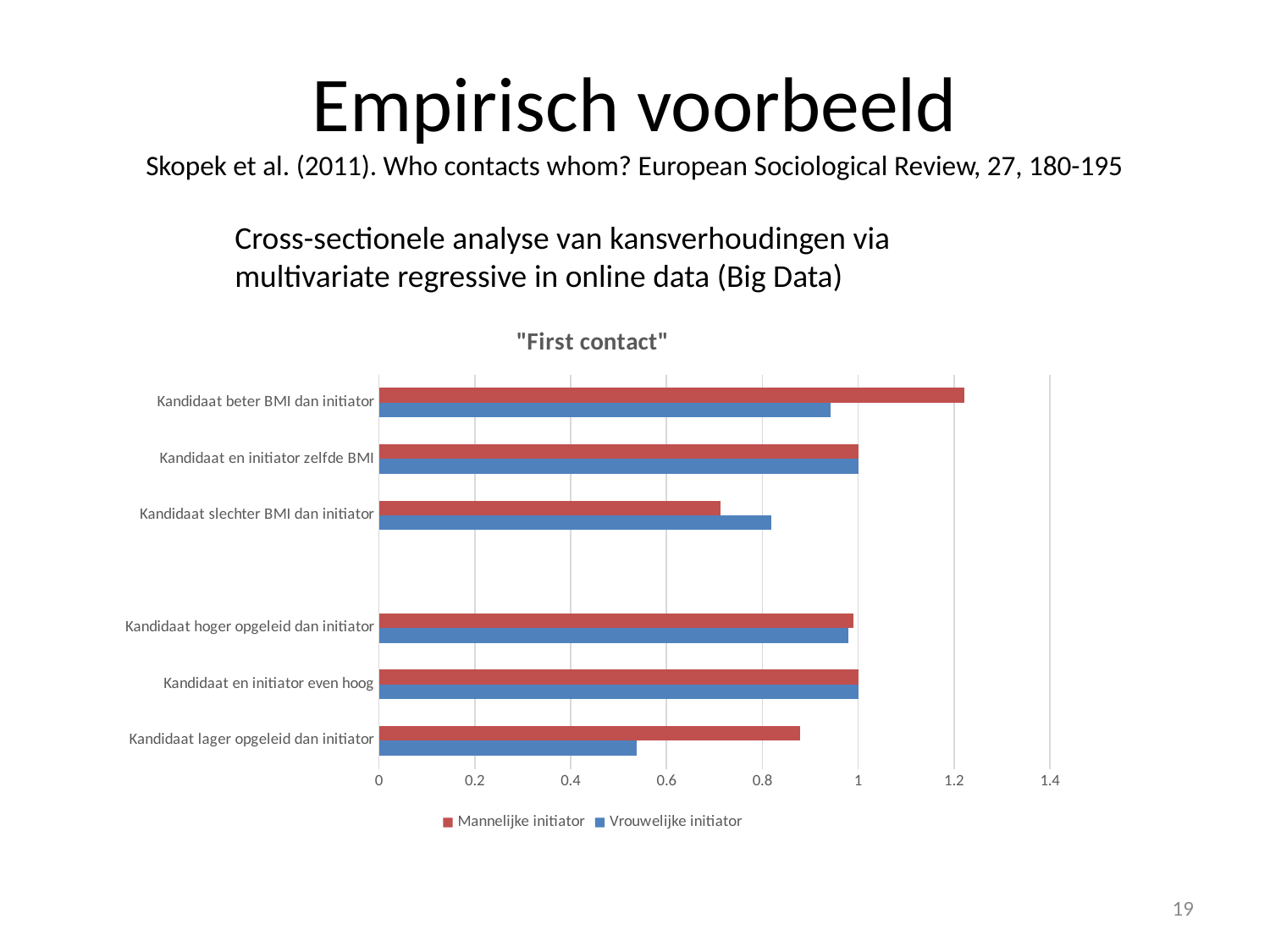
What is the value for Mannelijke initiator for 'Kandidaat en initiator zelfde BMI'? 1 What is the title of the chart? "First contact" Which series is shown in red? Mannelijke initiator Which category has the highest value for Mannelijke initiator? Kandidaat beter BMI dan initiator What kind of chart is shown on the slide? bar chart How many series does the legend list? 2 Is the value for Vrouwelijke initiator for 'Kandidaat lager opgeleid dan initiator' greater or less than 0.6? less What is the value for Vrouwelijke initiator for 'Kandidaat en initiator even hoog'? 1 Is the value for Mannelijke initiator for 'Kandidaat beter BMI dan initiator' greater or less than 1? greater Which category has the lowest value for Vrouwelijke initiator? Kandidaat lager opgeleid dan initiator For 'Kandidaat slechter BMI dan initiator', which series has the larger value, Mannelijke initiator or Vrouwelijke initiator? Vrouwelijke initiator How many labelled categories are shown on the y axis? 6